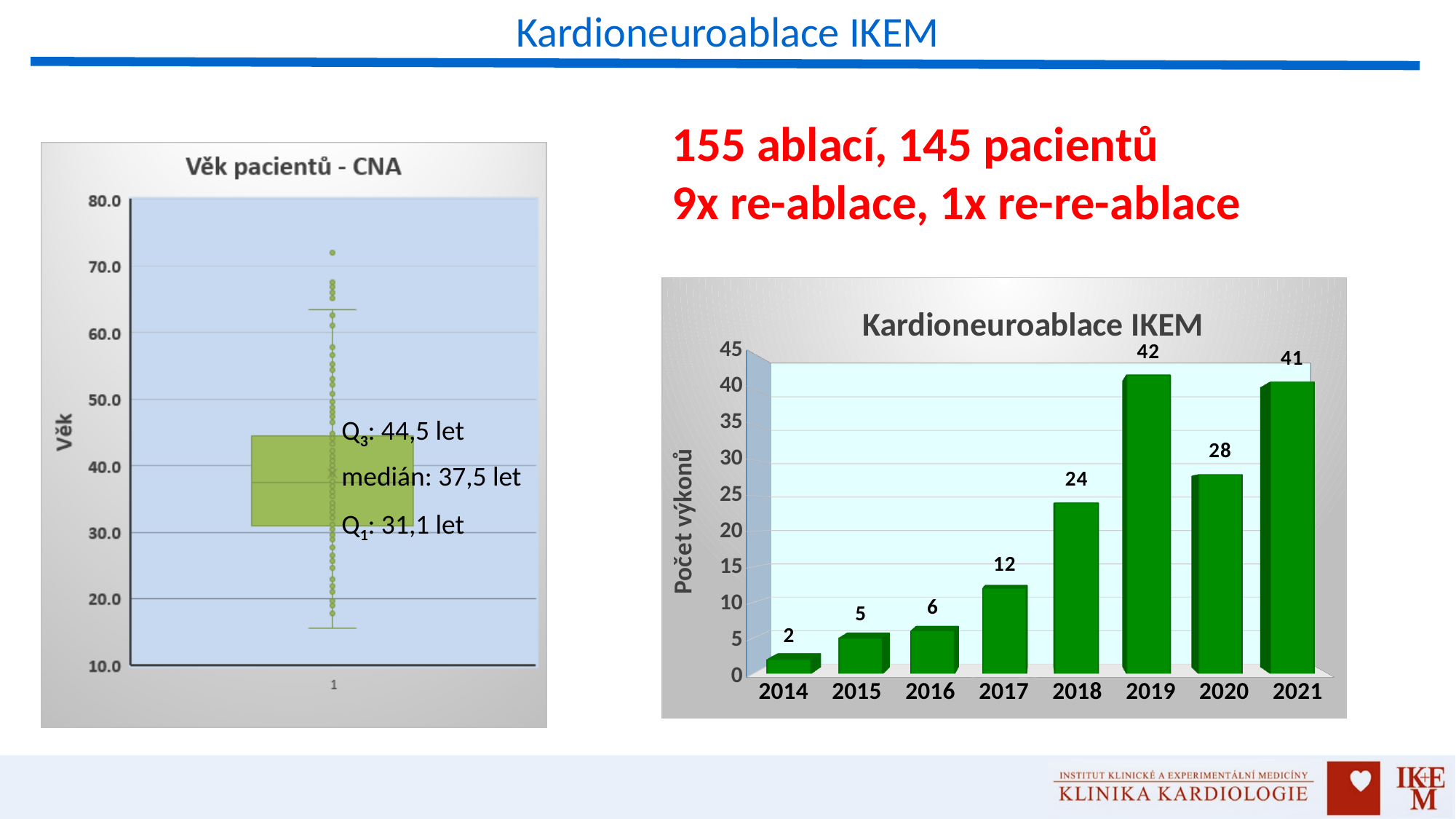
In the 'Kardioneuroablace IKEM' bar chart, what is the value for 2019? 42 In the 'Věk pacientů - CNA' chart on the left, what is the median age shown? 37,5 let In the 'Kardioneuroablace IKEM' bar chart, what is the value for 2018? 24 In the 'Kardioneuroablace IKEM' bar chart, what is the y-axis label? Počet výkonů In the 'Kardioneuroablace IKEM' bar chart, what is the value for 2014? 2 In the 'Věk pacientů - CNA' chart on the left, what is the value of Q3? 44,5 let In the 'Kardioneuroablace IKEM' bar chart, which is larger, the value for 2017 or the value for 2020? 2020 What kind of chart is the 'Kardioneuroablace IKEM' chart on the right? bar chart In the 'Kardioneuroablace IKEM' bar chart, which year has the highest value? 2019 In the 'Kardioneuroablace IKEM' bar chart, what is the difference between the values for 2019 and 2020? 14 In the 'Kardioneuroablace IKEM' bar chart, which year has the lowest value? 2014 In the 'Kardioneuroablace IKEM' bar chart, how many years are shown on the x axis? 8